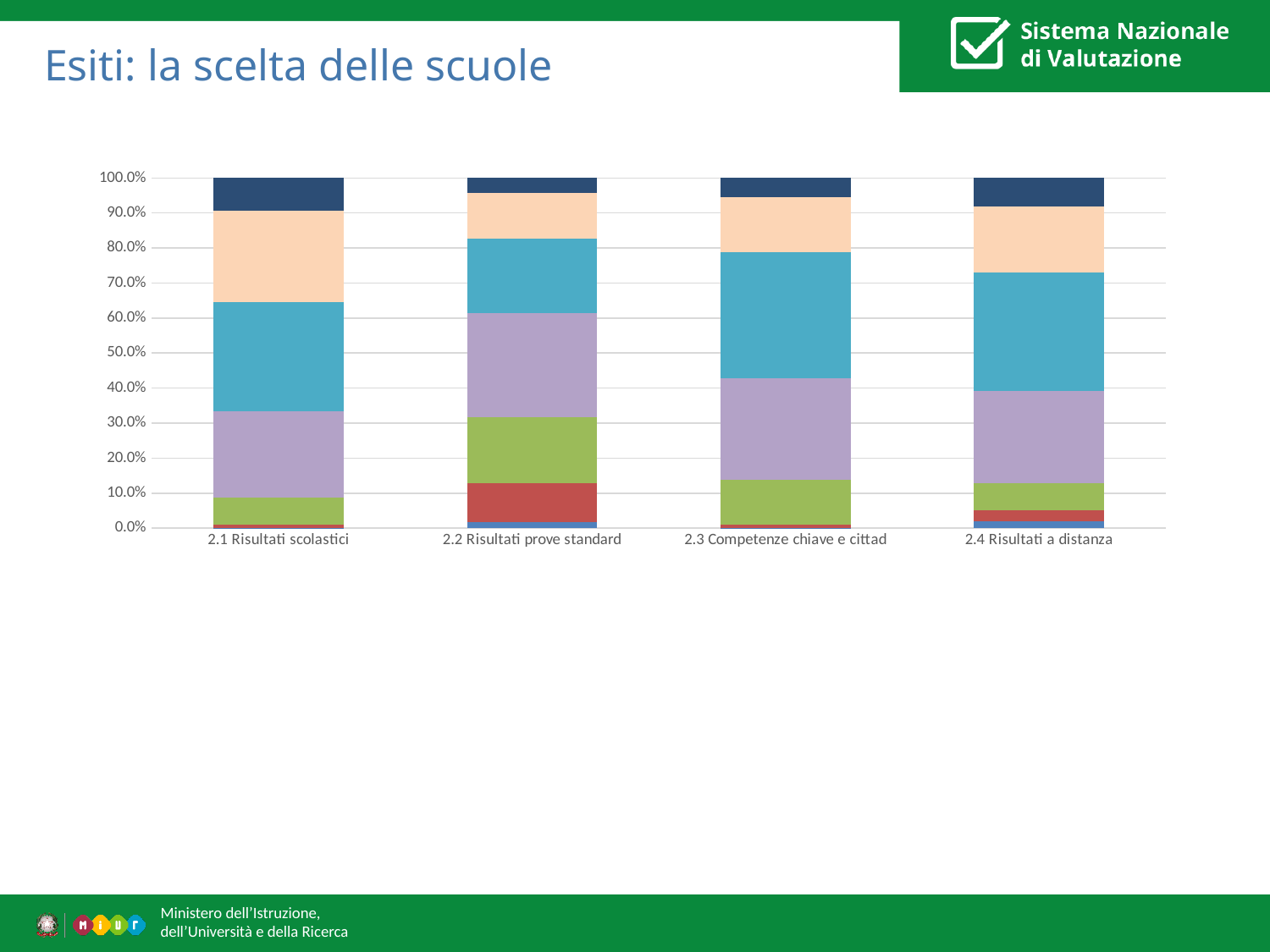
What kind of chart is shown on the slide? Stacked bar chart How many categories are shown on the x axis of the chart? 4 Which category has the larger green segment, 2.1 Risultati scolastici or 2.2 Risultati prove standard? 2.2 Risultati prove standard Is the top of the teal (light blue) segment for 2.1 Risultati scolastici greater or less than 60.0%? greater Is the top of the purple segment for 2.3 Competenze chiave e cittad greater or less than 40.0%? greater What is the total height of the stacked bar for 2.2 Risultati prove standard? 100.0% Is the top of the green segment for 2.1 Risultati scolastici greater or less than 10.0%? less What is the label of the first category on the x axis? 2.1 Risultati scolastici Which category has the larger red segment, 2.2 Risultati prove standard or 2.4 Risultati a distanza? 2.2 Risultati prove standard How many coloured segments make up each stacked bar? 7 What is the title of the slide containing the chart? Esiti: la scelta delle scuole